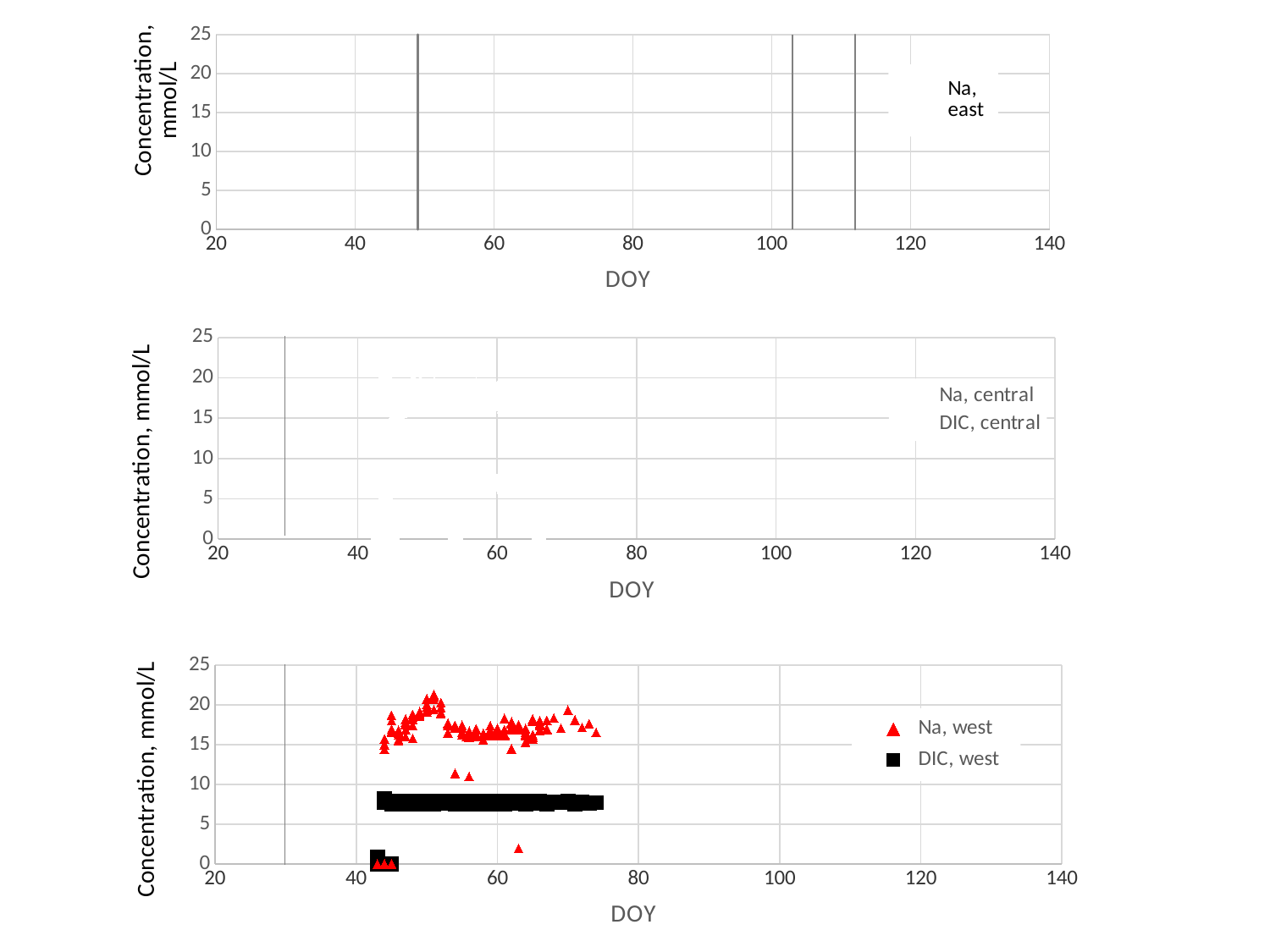
In the bottom chart, do the Na, west values rise or fall between DOY 43 and DOY 51? rise In the bottom chart, which series has higher values between DOY 45 and 75, Na, west or DIC, west? Na, west In the bottom chart, are the DIC, west values between DOY 45 and 75 greater or less than 10? less In the middle chart, how many series does the legend list? 2 In the bottom chart, is the highest Na, west value greater or less than 25? less In the bottom chart, what colour and marker shape are used for the Na, west series? red triangles In the bottom chart, how many series does the legend list? 2 What is the x-axis label of the bottom chart? DOY What kind of chart is the bottom chart? scatter chart In the bottom chart, is the highest Na, west value greater or less than 15? greater What is the legend entry shown in the top chart? Na, east